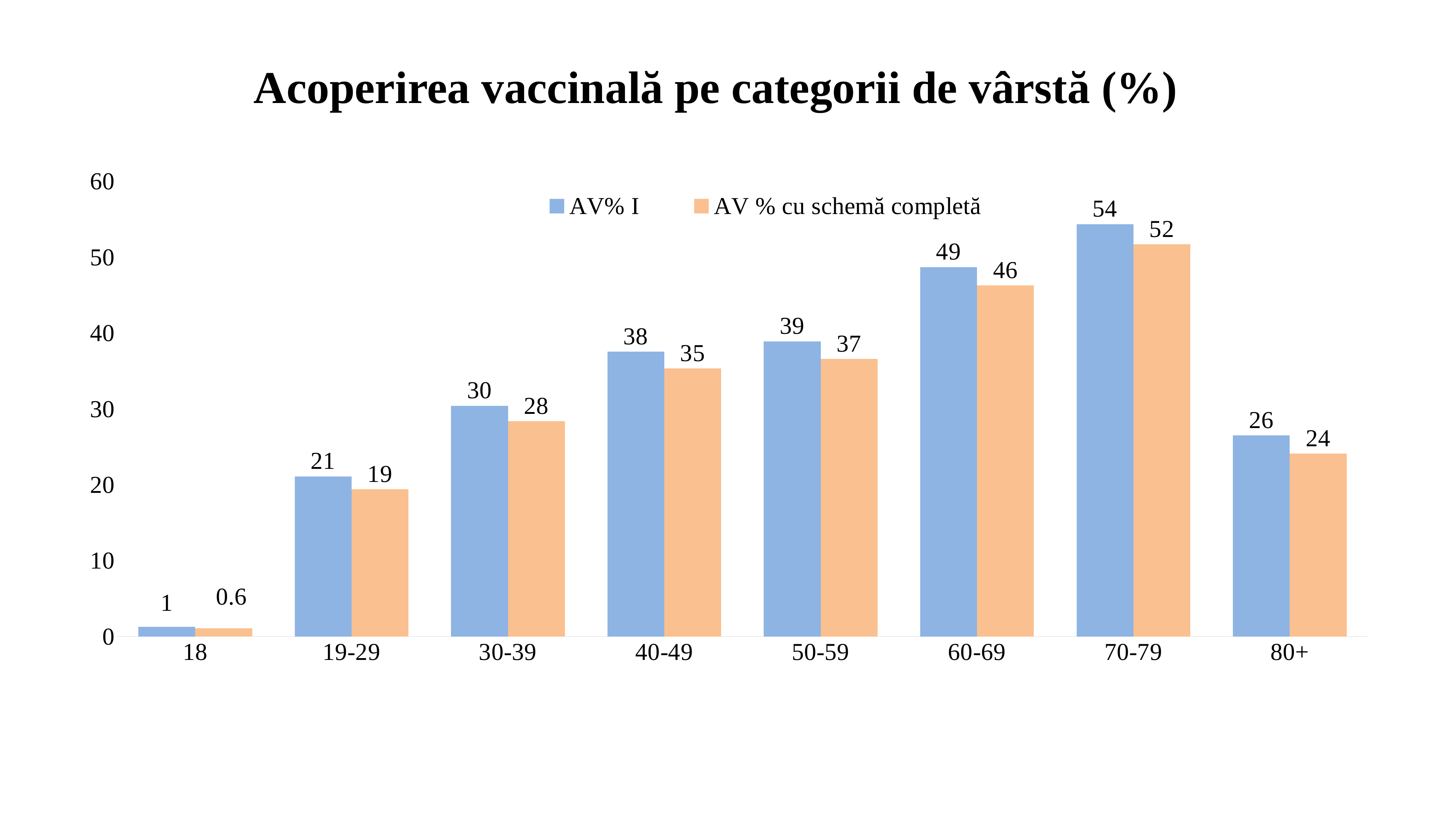
How many age groups are shown on the x axis? 8 How many series does the legend list? 2 Which is larger: the AV% I value for 50-59 or the AV% I value for 80+? 50-59 What is the difference between the AV% I and AV % cu schemă completă values for the 60-69 age group? 3 Which age group has the highest AV% I value? 70-79 What is the AV % cu schemă completă value for the 18 age group? 0.6 What is the AV% I value for the 40-49 age group? 38 Is the AV % cu schemă completă value for 70-79 greater or less than 50? greater What is the AV % cu schemă completă value for the 19-29 age group? 19 What kind of chart is shown on the slide? bar chart Which age group has the lowest AV % cu schemă completă value? 18 What is the title of the chart? Acoperirea vaccinală pe categorii de vârstă (%)